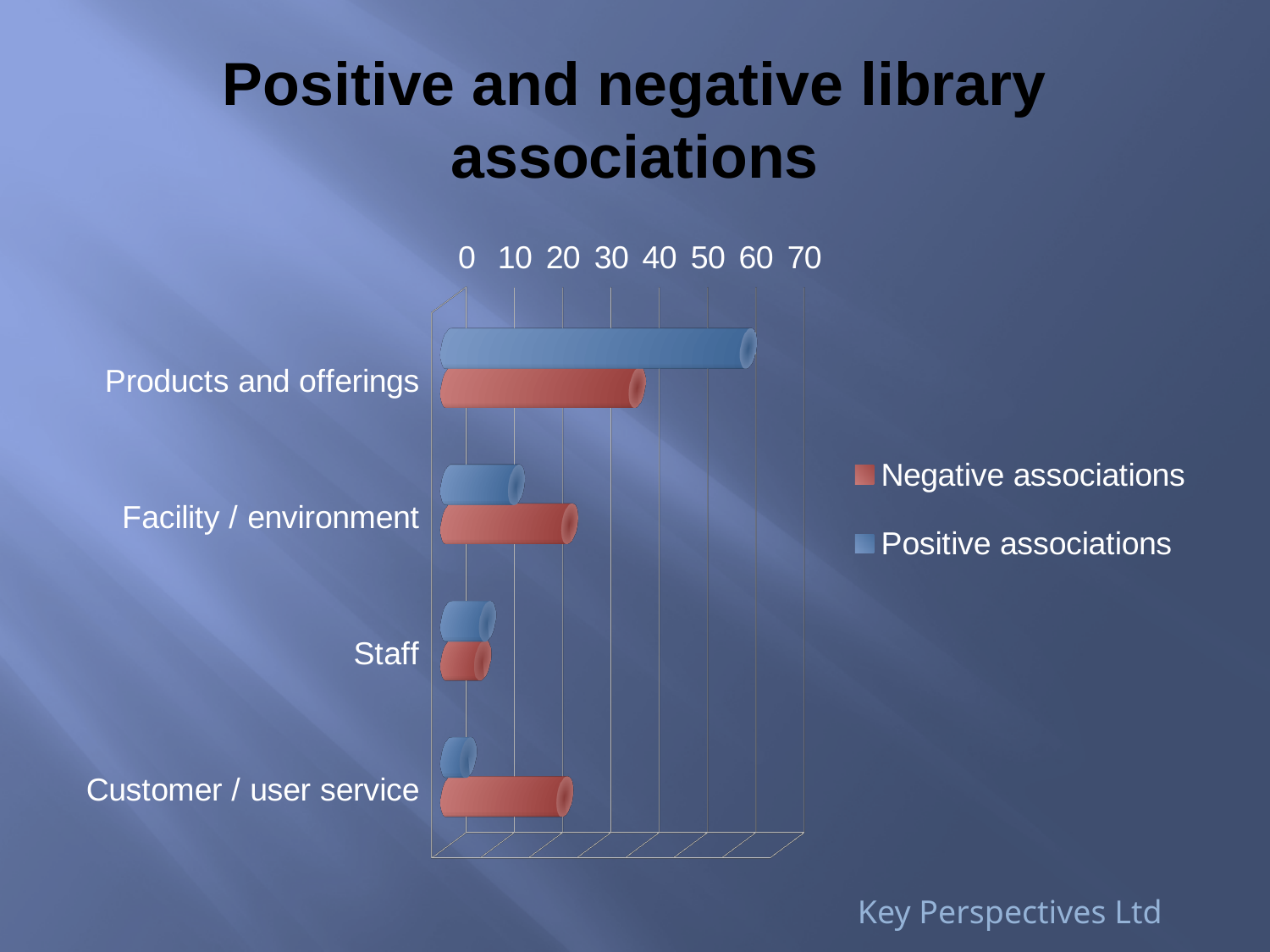
Is the value for Positive associations for Customer / user service greater or less than 10? less Which category has the lowest value for Positive associations? Customer / user service Is the value for Positive associations for Products and offerings greater or less than 50? greater What kind of chart is shown on the slide? bar chart Is the value for Negative associations for Products and offerings greater or less than 30? greater For Customer / user service, which is larger: Positive associations or Negative associations? Negative associations How many series does the legend list? 2 How many categories are shown on the chart? 4 Which category has the highest value for Negative associations? Products and offerings For Products and offerings, which is larger: Positive associations or Negative associations? Positive associations Which colour represents Negative associations in the legend? red Which category has the highest value for Positive associations? Products and offerings